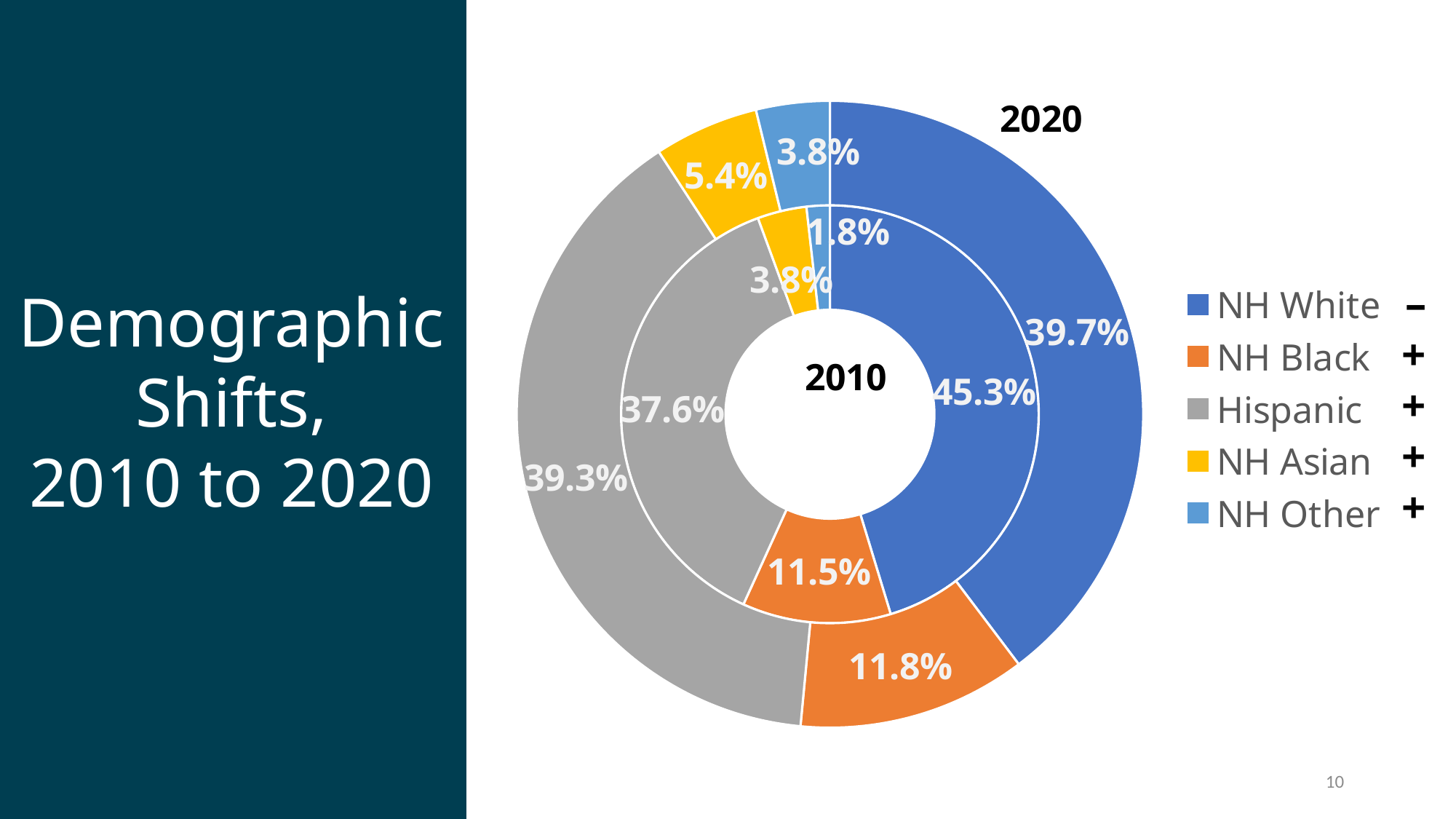
What was the Hispanic share in 2020? 39.3% What type of chart is shown on the slide? Doughnut chart What was the NH Other share in 2020? 3.8% Which group had the smallest share in 2020? NH Other What share of the population was NH White in 2010? 45.3% Which group had the largest share in 2010? NH White How many demographic groups does the legend list? 5 What was the NH Asian share in 2010? 3.8% Which was larger in 2010: the Hispanic share or the NH Black share? Hispanic What share of the population was NH White in 2020? 39.7% Which year does the inner ring of the chart represent? 2010 By how many percentage points did the NH White share change from 2010 to 2020? 5.6 percentage points